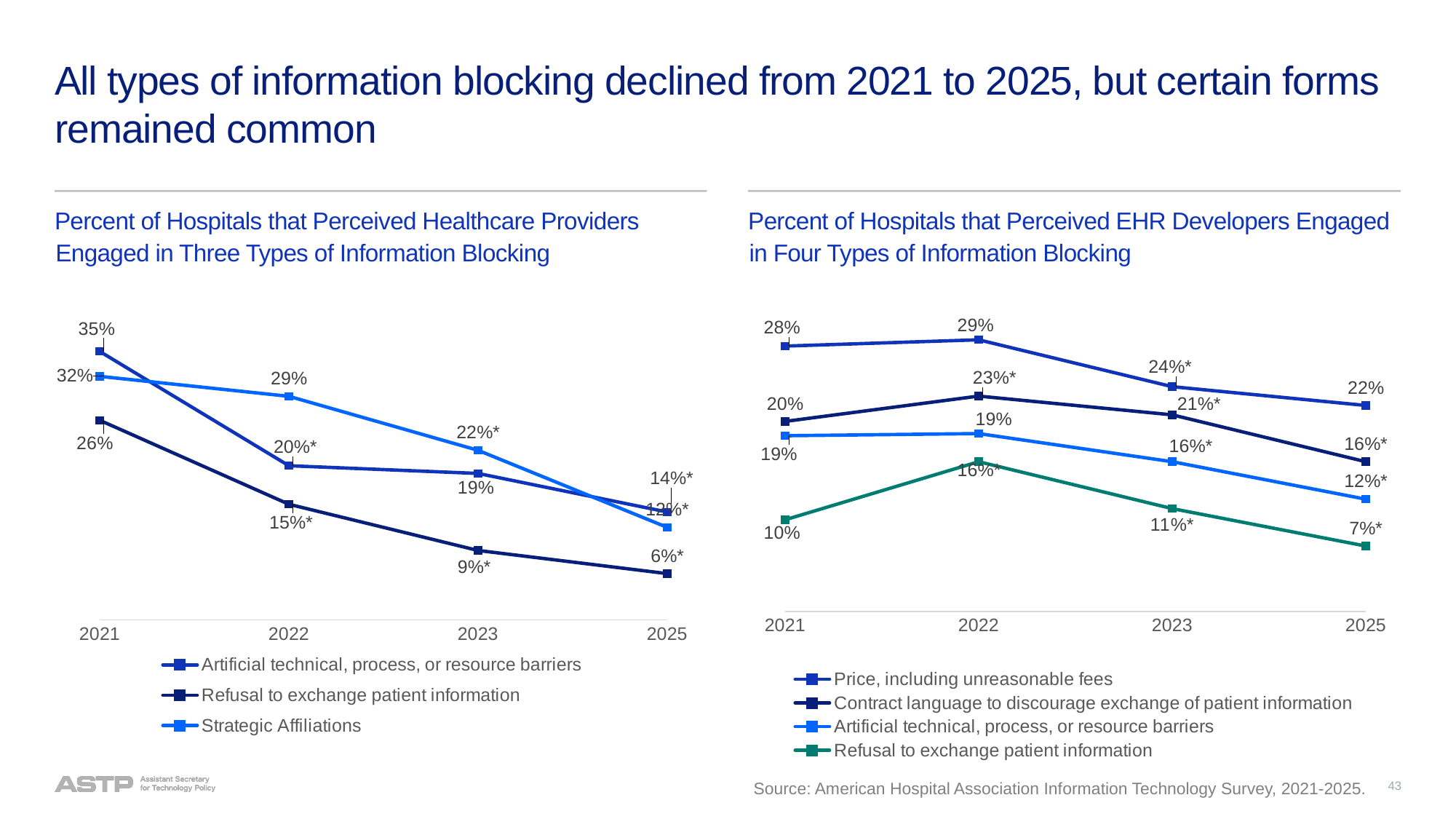
In the right chart (EHR Developers), how many years are shown on the x axis? 4 In the left chart (Healthcare Providers), which series has the lowest value in 2023? Refusal to exchange patient information In the left chart (Healthcare Providers), what is the value for Refusal to exchange patient information in 2025? 6%* In the right chart (EHR Developers), what is the value for Price, including unreasonable fees in 2022? 29% In the right chart (EHR Developers), is the 2023 value for Contract language to discourage exchange of patient information larger or smaller than the 2023 value for Artificial technical, process, or resource barriers? larger In the left chart (Healthcare Providers), what percent of hospitals perceived artificial technical, process, or resource barriers in 2021? 35% In the right chart (EHR Developers), what is the value for Refusal to exchange patient information in 2021? 10% In the left chart (Healthcare Providers), what is the value for Strategic Affiliations in 2022? 29% In the left chart (Healthcare Providers), what is the difference between the 2021 and 2025 values for Refusal to exchange patient information? 20 percentage points What type of chart is used on the right side of the slide (EHR Developers)? Line chart In the left chart (Healthcare Providers), how many series does the legend list? 3 In the right chart (EHR Developers), which series has the highest value in 2025? Price, including unreasonable fees